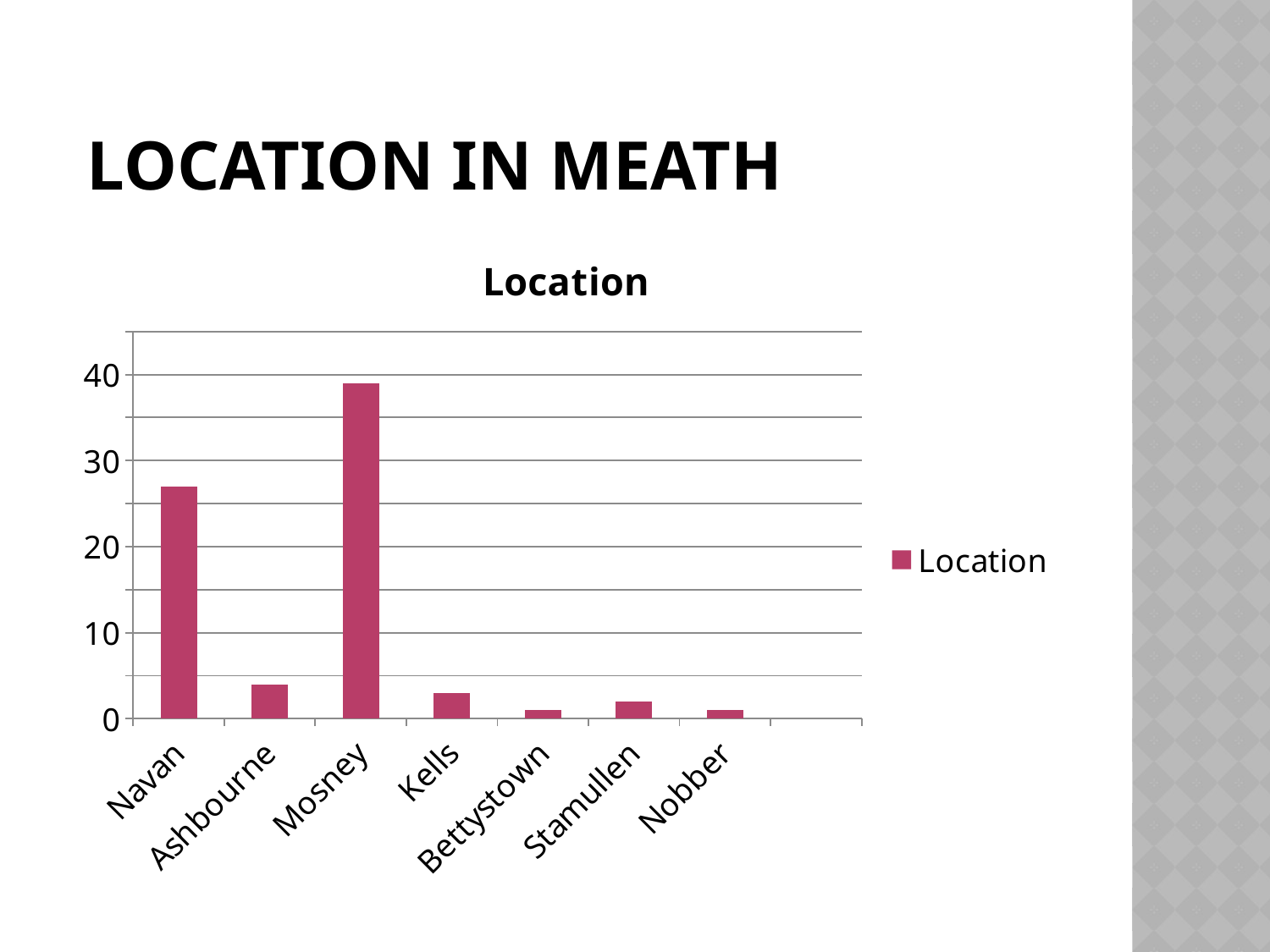
Which has the larger value, Navan or Ashbourne? Navan What is the title of the chart? Location What kind of chart is shown on the slide? bar chart Is the value for Navan greater or less than 30? less How many locations are shown on the x axis? 7 Is the value for Kells greater or less than 10? less Is the value for Navan greater or less than 20? greater Which has the larger value, Navan or Mosney? Mosney Which location has the highest value? Mosney How many series does the legend list? 1